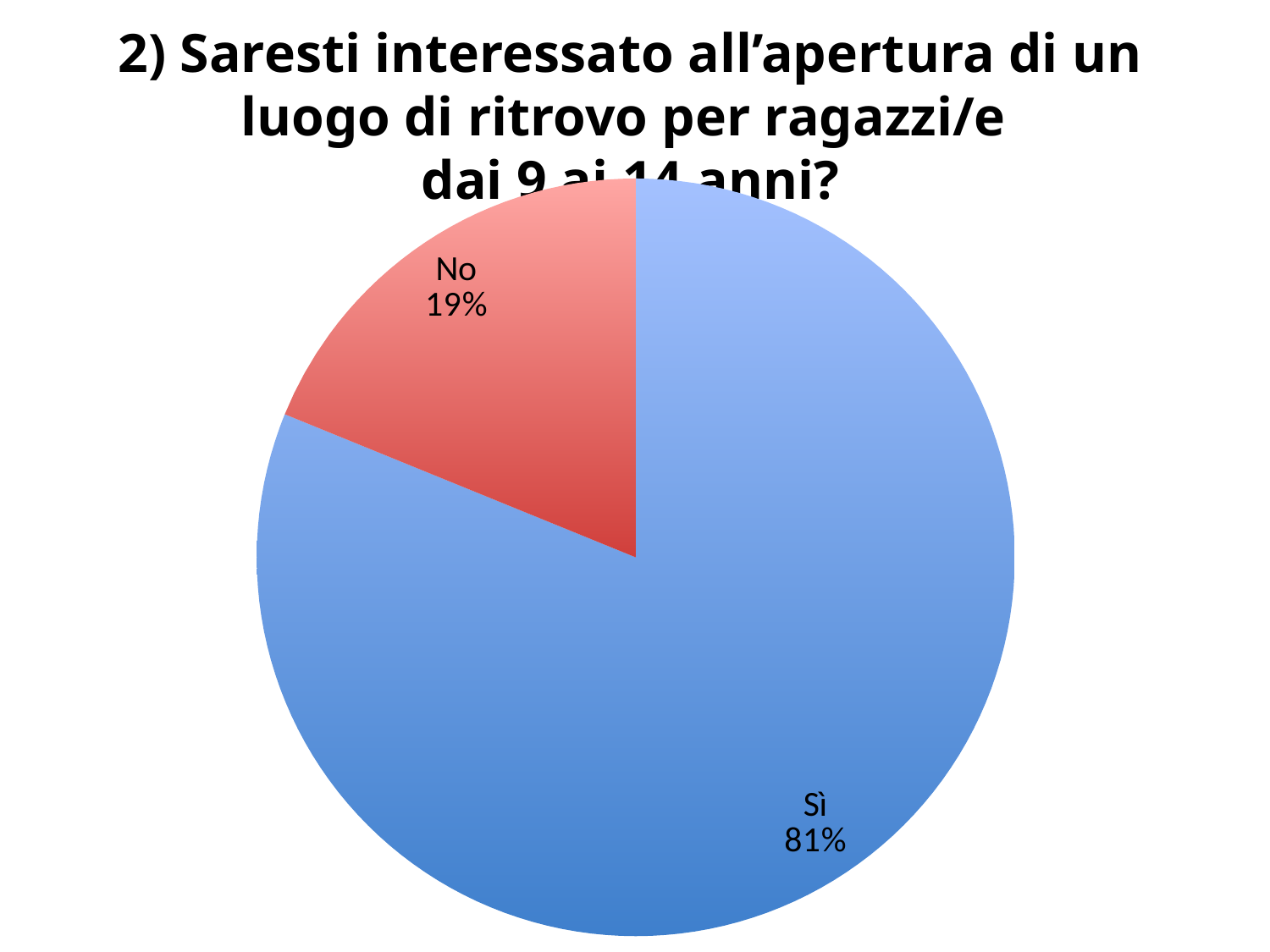
What percentage of respondents answered "Sì"? 81% What colour is the "No" slice? Red Which response has the smallest share of the pie? No What share of the pie does the "No" slice represent? 19% What colour is the "Sì" slice? Blue Which response has the largest share of the pie? Sì What percentage of respondents answered "No"? 19% What kind of chart is shown on the slide? Pie chart How many slices does the pie chart have? 2 What is the difference in percentage points between the "Sì" and "No" shares? 62 Which is larger, the share for "Sì" or the share for "No"? Sì